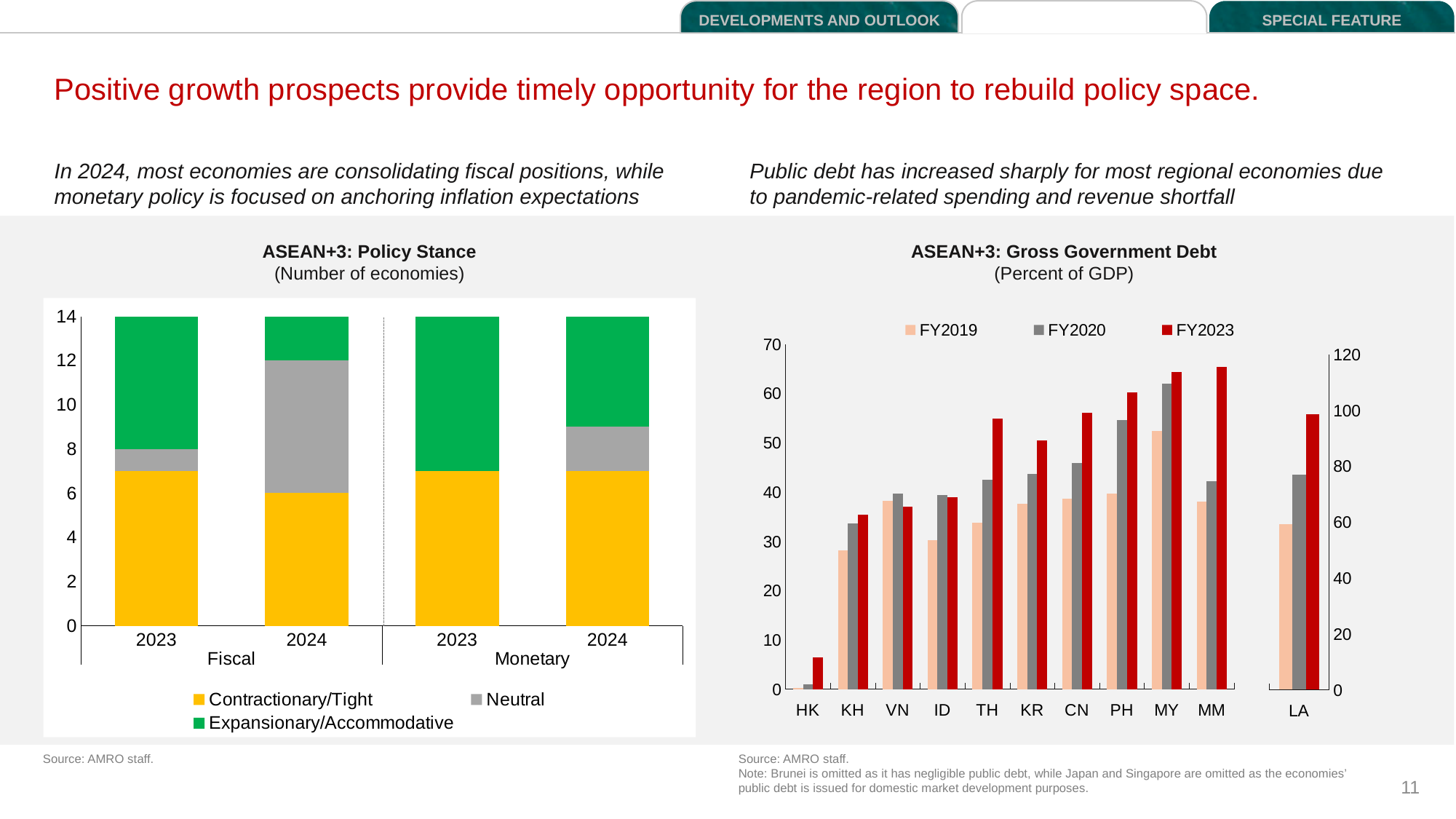
What kind of chart is the ASEAN+3: Gross Government Debt chart? bar chart In the ASEAN+3: Gross Government Debt chart, how many economies are shown on the x axis? 11 In the ASEAN+3: Policy Stance chart, how many economies have a Contractionary/Tight fiscal stance in 2024? 6 In the ASEAN+3: Gross Government Debt chart, which economy has the lowest FY2023 value? HK In the ASEAN+3: Gross Government Debt chart, is the FY2023 value for TH greater or less than 50? greater In the ASEAN+3: Policy Stance chart, how many stacked bars are plotted? 4 In the ASEAN+3: Gross Government Debt chart, which series does the legend list? FY2019, FY2020, FY2023 In the ASEAN+3: Policy Stance chart, which bar has no Neutral segment? Monetary 2023 In the ASEAN+3: Gross Government Debt chart, is the FY2023 value for TH larger than its FY2019 value? Yes In the ASEAN+3: Policy Stance chart, is the Neutral segment larger for Fiscal 2023 or Fiscal 2024? Fiscal 2024 In the ASEAN+3: Policy Stance chart, how many series does the legend list? 3 In the ASEAN+3: Policy Stance chart, what is the total number of economies in the Fiscal 2023 stacked bar? 14